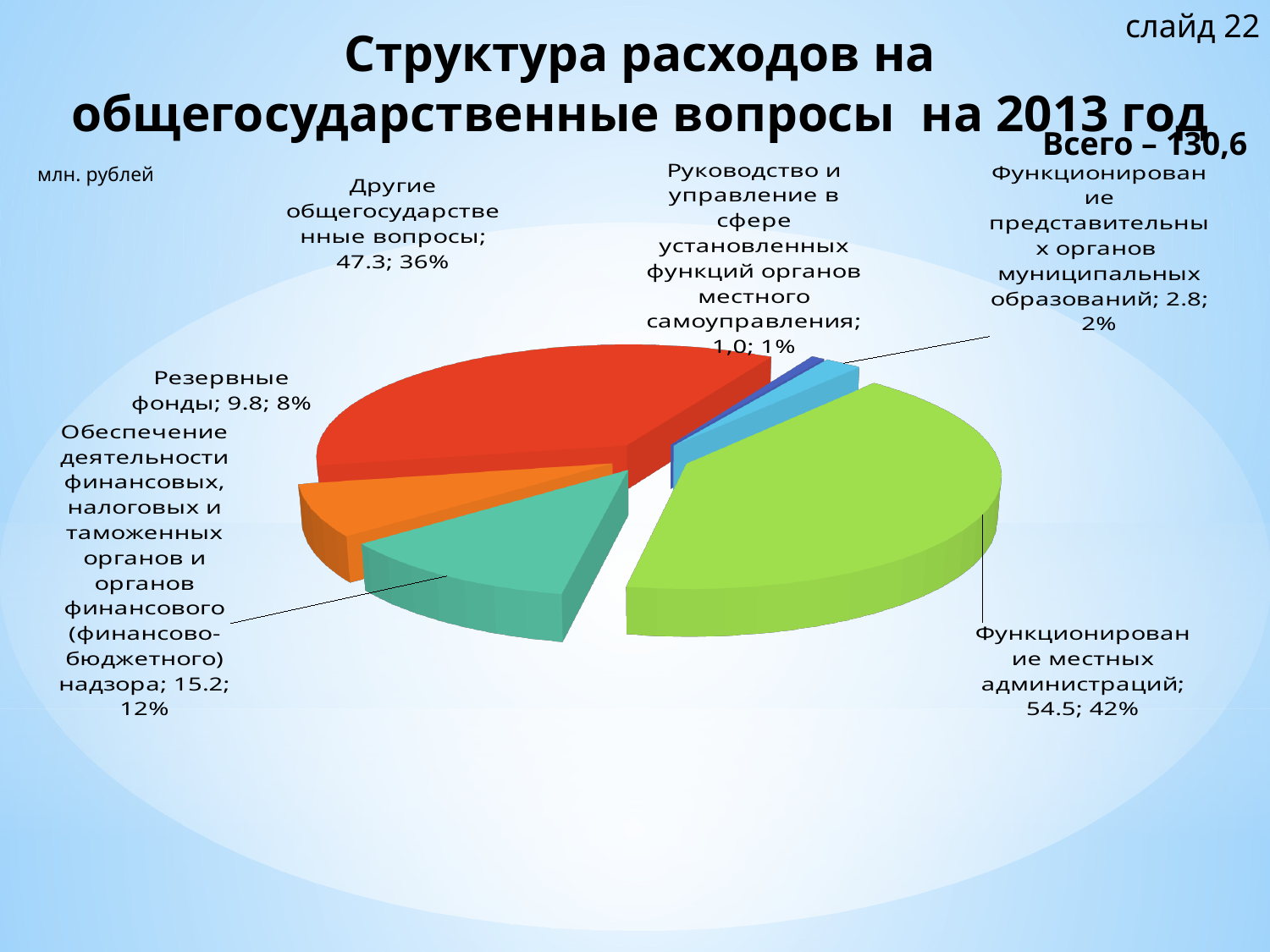
Какую долю составляют «Другие общегосударственные вопросы»? 36% Какое значение (млн. рублей) приходится на «Резервные фонды»? 9.8 Какая категория имеет наименьшую долю расходов? Руководство и управление в сфере установленных функций органов местного самоуправления Сколько категорий (секторов) показано на круговой диаграмме? 6 Какую долю составляет «Функционирование представительных органов муниципальных образований»? 2% В каких единицах измерения приведены значения на диаграмме? млн. рублей Какая категория имеет наибольшую долю расходов? Функционирование местных администраций Что больше: расходы на «Резервные фонды» или на «Обеспечение деятельности финансовых, налоговых и таможенных органов и органов финансового (финансово-бюджетного) надзора»? Обеспечение деятельности финансовых, налоговых и таможенных органов и органов финансового (финансово-бюджетного) надзора Какая общая сумма расходов указана на слайде? 130,6 Какой тип диаграммы показан на слайде? Круговая диаграмма На сколько млн. рублей расходы на «Функционирование местных администраций» больше, чем на «Другие общегосударственные вопросы»? 7.2 Какое значение (млн. рублей) приходится на «Функционирование местных администраций»? 54.5